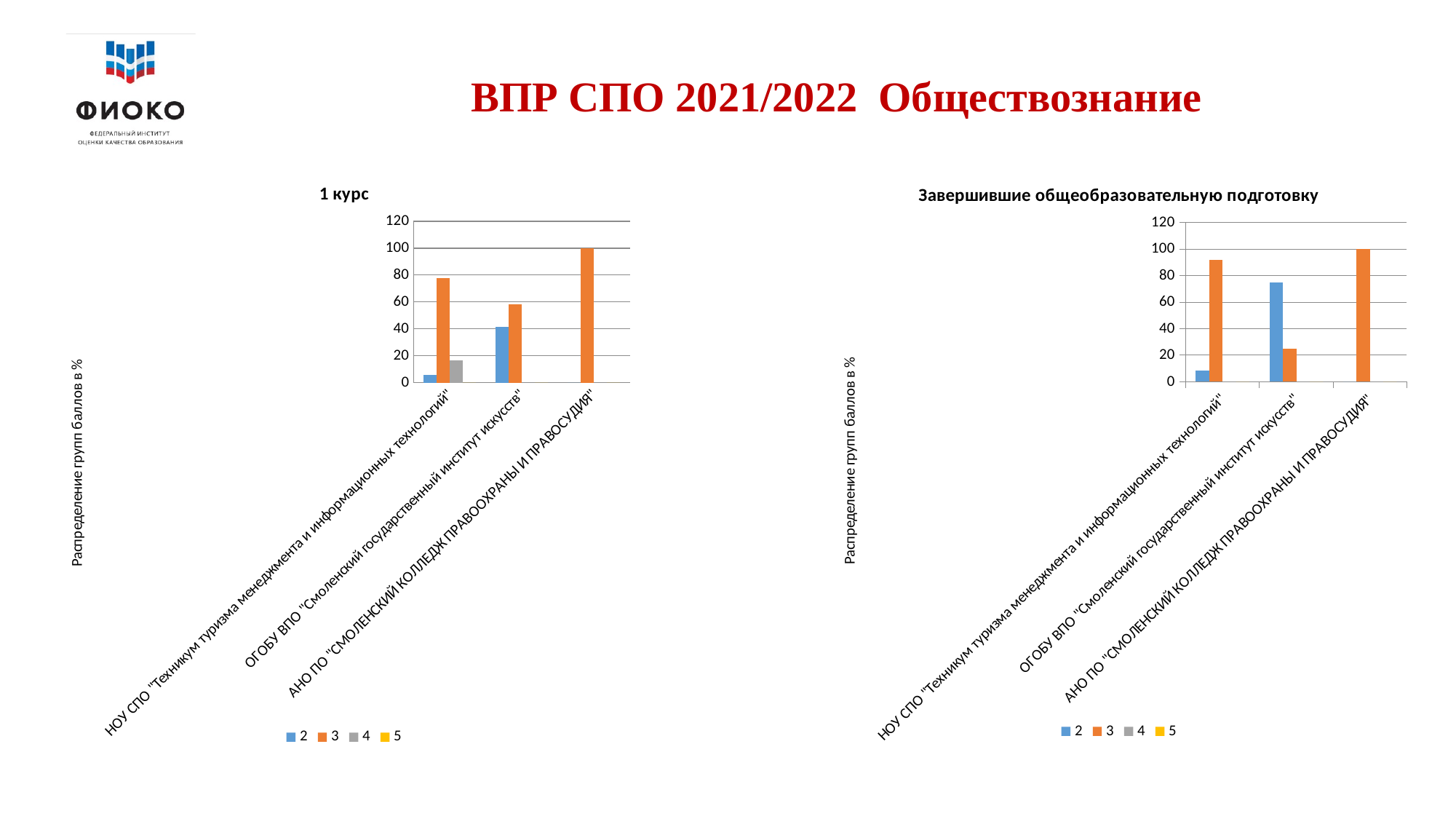
In the "Завершившие общеобразовательную подготовку" chart, for ОГОБУ ВПО "Смоленский государственный институт искусств", which is larger: series 2 or series 3? series 2 What kind of chart is the "1 курс" chart? bar chart What is the y-axis label of the "1 курс" chart? Распределение групп баллов в % In the "1 курс" chart, which category has the highest value for series 3? АНО ПО "СМОЛЕНСКИЙ КОЛЛЕДЖ ПРАВООХРАНЫ И ПРАВОСУДИЯ" In the "1 курс" chart, what is the value of series 3 for АНО ПО "СМОЛЕНСКИЙ КОЛЛЕДЖ ПРАВООХРАНЫ И ПРАВОСУДИЯ"? 100 In the "1 курс" chart, is the value of series 2 for ОГОБУ ВПО "Смоленский государственный институт искусств" greater or less than 60? less How many categories are shown on the x axis of the "Завершившие общеобразовательную подготовку" chart? 3 How many series does the legend of the "1 курс" chart list? 4 In the "1 курс" chart, is the value of series 3 for НОУ СПО "Техникум туризма менеджмента и информационных технологий" greater or less than 60? greater In the "Завершившие общеобразовательную подготовку" chart, what is the value of series 3 for АНО ПО "СМОЛЕНСКИЙ КОЛЛЕДЖ ПРАВООХРАНЫ И ПРАВОСУДИЯ"? 100 In the "Завершившие общеобразовательную подготовку" chart, is the value of series 2 for ОГОБУ ВПО "Смоленский государственный институт искусств" greater or less than 60? greater